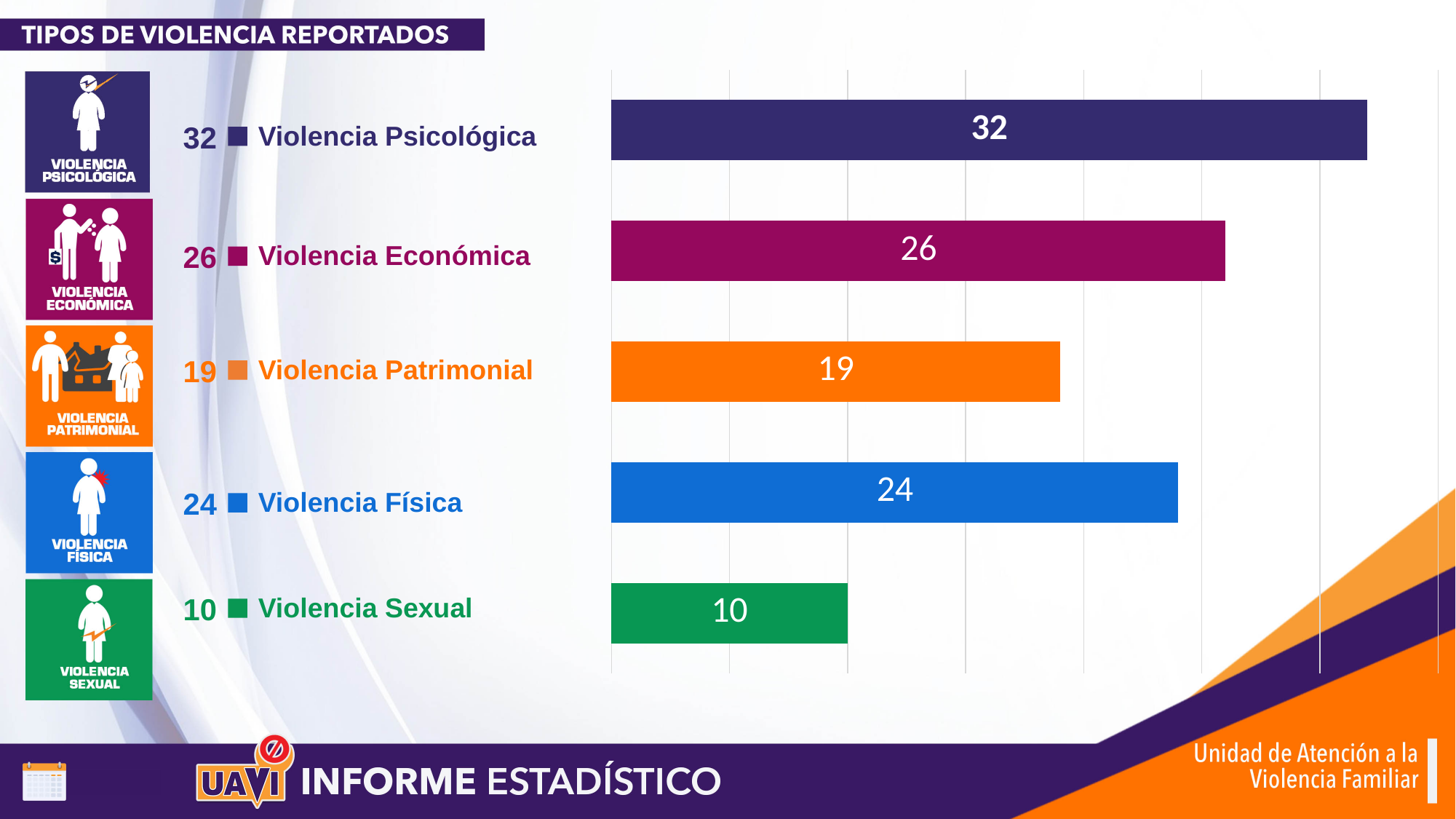
What kind of chart is shown on the slide? Bar chart What is the value for Violencia Sexual? 10 What is the difference between the values for Violencia Psicológica and Violencia Sexual? 22 How many types of violence are shown in the chart? 5 Which type of violence has the highest reported value? Violencia Psicológica What is the value for Violencia Patrimonial? 19 Which is larger, the value for Violencia Patrimonial or the value for Violencia Física? Violencia Física What is the difference between the values for Violencia Económica and Violencia Física? 2 What is the value for Violencia Psicológica? 32 What is the value for Violencia Física? 24 What is the value for Violencia Económica? 26 Which type of violence has the lowest reported value? Violencia Sexual